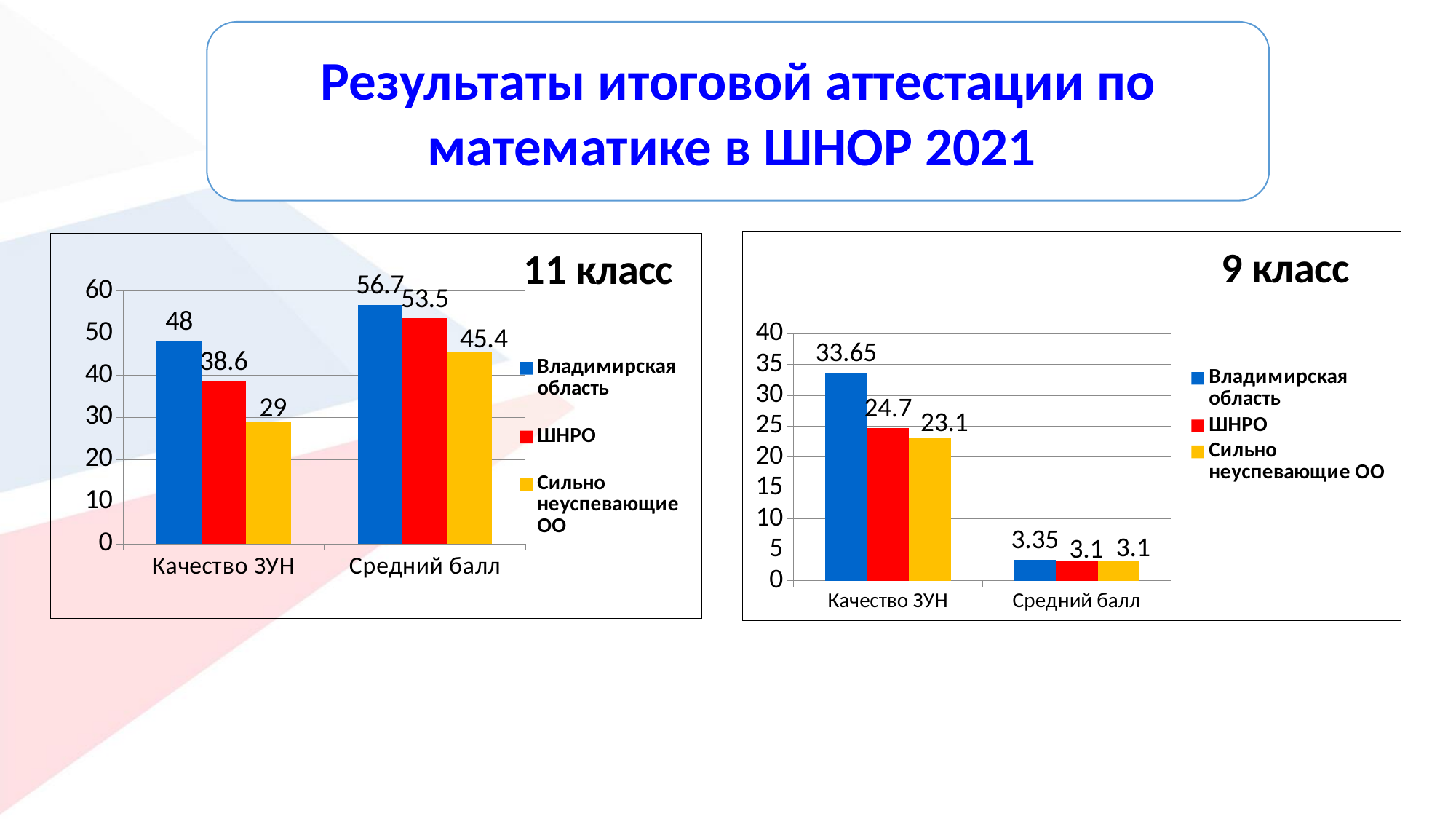
In the "9 класс" chart, what is the value for ШНРО in the Качество ЗУН category? 24.7 How many series does the legend of the "9 класс" chart list? 3 In the "11 класс" chart, what is the value for Сильно неуспевающие ОО in the Средний балл category? 45.4 What type of chart is the "11 класс" chart? bar chart In the "9 класс" chart, which colour represents ШНРО? red In the "11 класс" chart, is the ШНРО value for Качество ЗУН larger or smaller than the ШНРО value for Средний балл? smaller In the "11 класс" chart, which series has the lowest value in the Качество ЗУН category? Сильно неуспевающие ОО In the "9 класс" chart, what is the difference between the Владимирская область and Сильно неуспевающие ОО values in the Качество ЗУН category? 10.55 In the "9 класс" chart, what is the value for Владимирская область in the Средний балл category? 3.35 In the "11 класс" chart, what is the value for Владимирская область in the Качество ЗУН category? 48 In the "11 класс" chart, what is the difference between the Владимирская область and ШНРО values in the Средний балл category? 3.2 In the "9 класс" chart, which series has the highest value in the Качество ЗУН category? Владимирская область